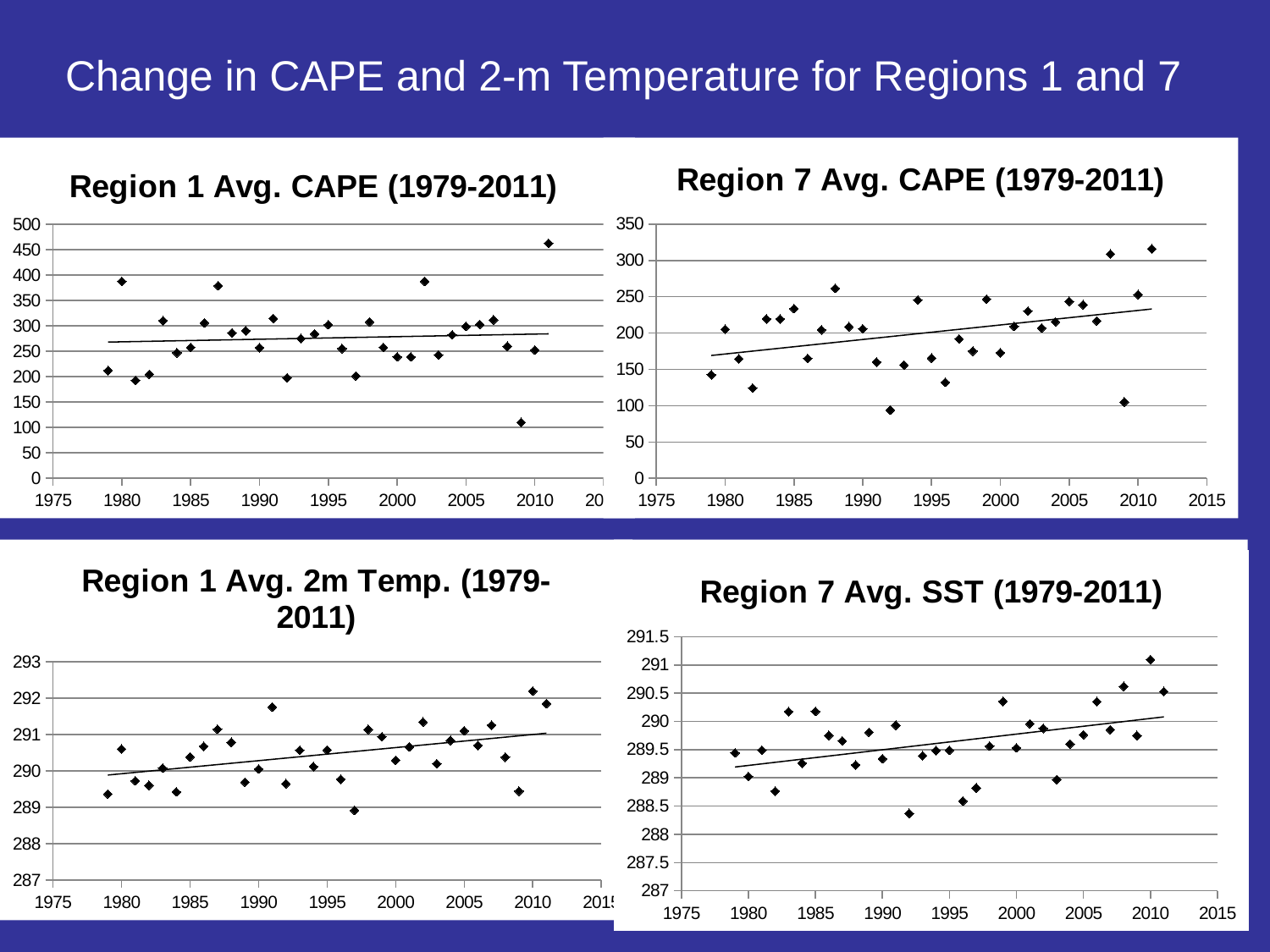
In the 'Region 1 Avg. CAPE (1979-2011)' chart, is the value for 2009 greater or less than 150? less In the 'Region 7 Avg. SST (1979-2011)' chart, which year has the highest value? 2010 In the 'Region 7 Avg. CAPE (1979-2011)' chart, is the value for 1992 greater or less than 150? less In the 'Region 1 Avg. 2m Temp. (1979-2011)' chart, which year has the lowest value? 1997 In the 'Region 7 Avg. CAPE (1979-2011)' chart, is the value for 2011 greater or less than 300? greater In the 'Region 1 Avg. CAPE (1979-2011)' chart, which year has the highest value? 2011 What kind of chart is 'Region 1 Avg. CAPE (1979-2011)'? scatter chart In the 'Region 1 Avg. 2m Temp. (1979-2011)' chart, does the trend line rise or fall across the years? rise In the 'Region 1 Avg. CAPE (1979-2011)' chart, which year has the lowest value? 2009 In the 'Region 7 Avg. CAPE (1979-2011)' chart, does the trend line rise or fall from 1979 to 2011? rise In the 'Region 7 Avg. SST (1979-2011)' chart, does the trend line rise or fall across the years? rise